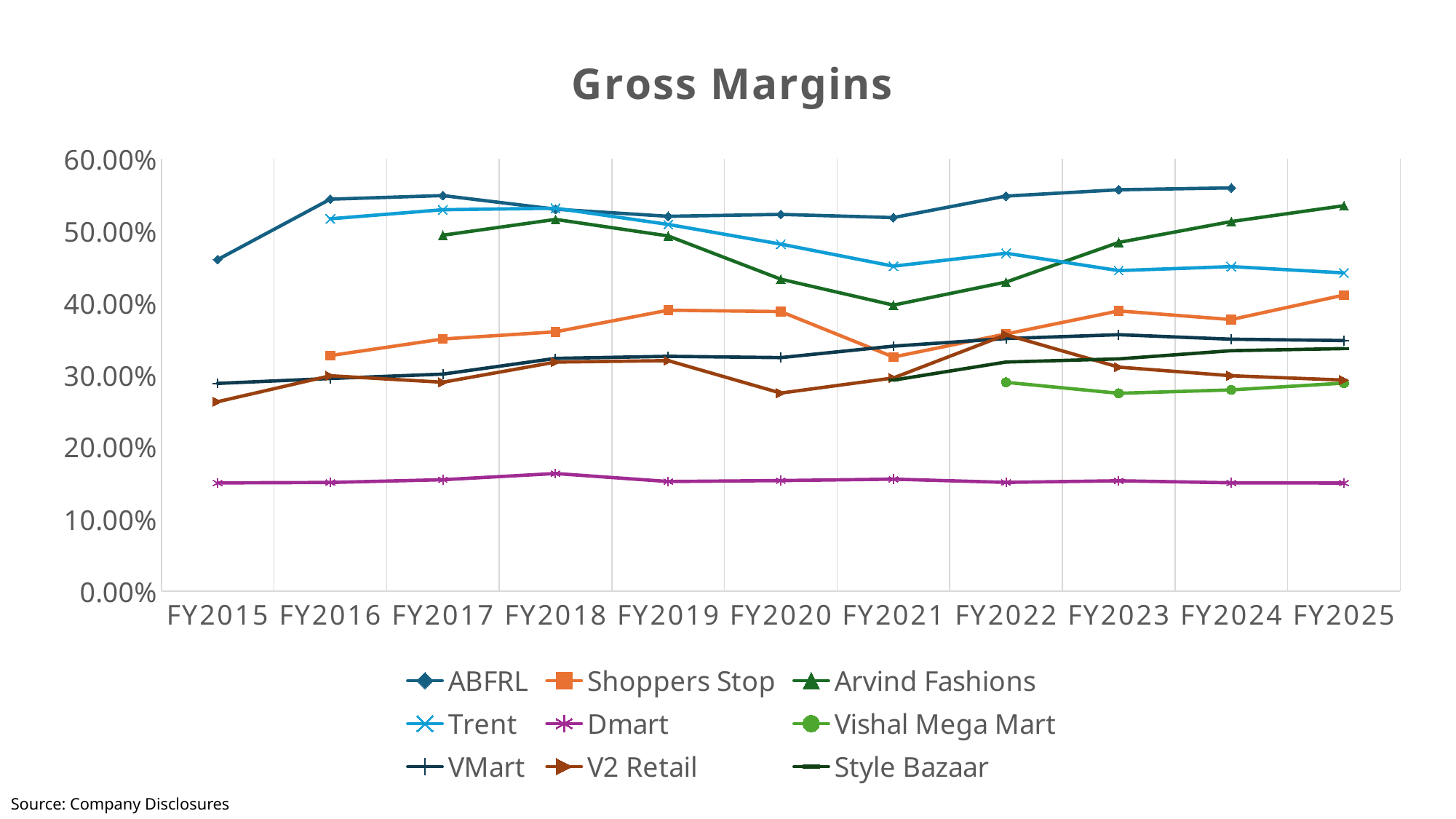
Which series has the highest gross margin in FY2024? ABFRL Is the value for Vishal Mega Mart in FY2023 greater or less than 30.00%? less Which series has the lowest gross margin in FY2025? Dmart What kind of chart is shown on the slide? line chart Is the value for Dmart in FY2018 greater or less than 20.00%? less Does the gross margin of Arvind Fashions rise or fall from FY2021 to FY2025? rise What is the title of the chart? Gross Margins Is the value for ABFRL in FY2016 greater or less than 50.00%? greater How many fiscal years are shown on the x axis? 11 How many series does the legend list? 9 In FY2021, which is larger: the gross margin of Trent or of Arvind Fashions? Trent Which series has the highest gross margin in FY2025? Arvind Fashions